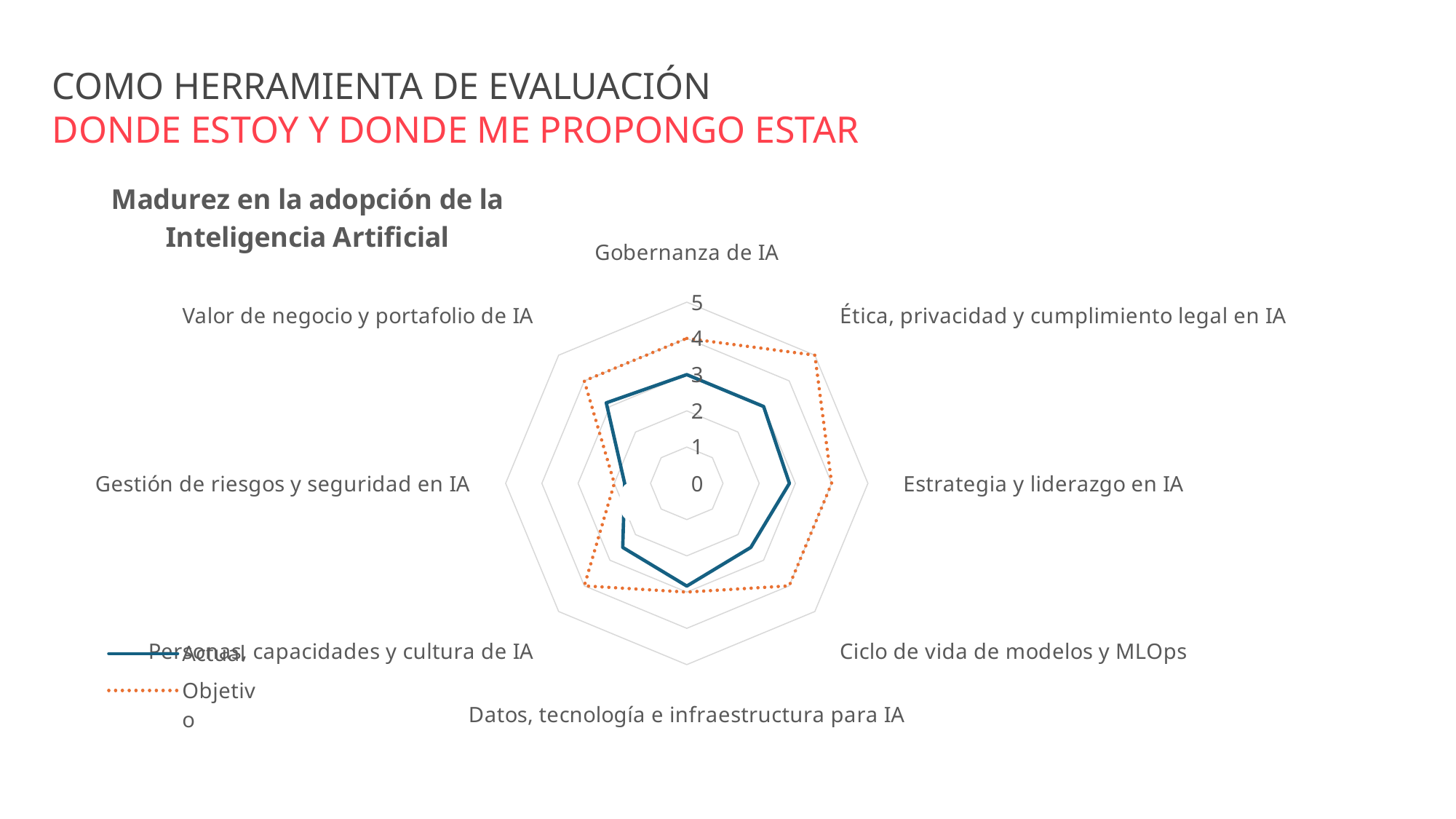
What is the Objetivo value for Gobernanza de IA? 4 Is the Objetivo value for Ética, privacidad y cumplimiento legal en IA greater or less than 4? greater What kind of chart is shown on the slide? Radar chart What is the title of the chart? Madurez en la adopción de la Inteligencia Artificial For which category does the Objetivo series reach its highest value? Ética, privacidad y cumplimiento legal en IA How many categories (axes) does the radar chart have? 8 Is the Actual value for Gestión de riesgos y seguridad en IA greater or less than 3? less How many series does the legend list? 2 What is the Actual value for Gobernanza de IA? 3 For Ética, privacidad y cumplimiento legal en IA, which is larger: the Actual value or the Objetivo value? Objetivo For which category is the Actual value lowest? Gestión de riesgos y seguridad en IA Which series is drawn with a dotted orange line? Objetivo